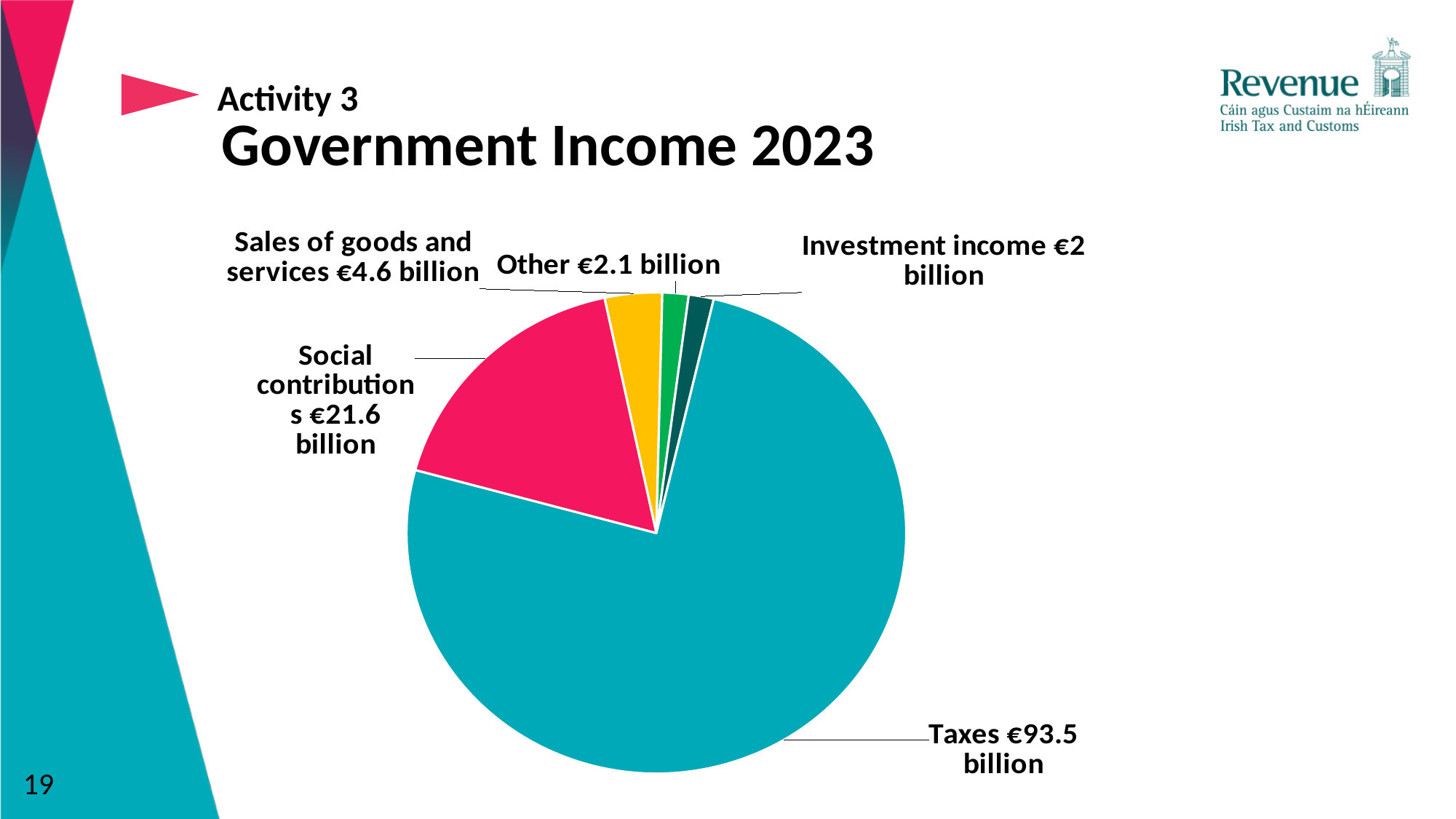
How many slices does the pie chart have? 5 What type of chart is shown on the slide? Pie chart What is the title of the chart on the slide? Government Income 2023 Which category has the smallest value in the pie chart? Investment income What is the value for Sales of goods and services? €4.6 billion Which category has the largest slice of the pie? Taxes What is the total of all the values shown in the pie chart? €123.8 billion What is the value for Taxes in the pie chart? €93.5 billion Which is larger, Other or Investment income? Other What is the difference between Taxes and Social contributions? €71.9 billion What is the value for Investment income? €2 billion What is the value for Social contributions? €21.6 billion